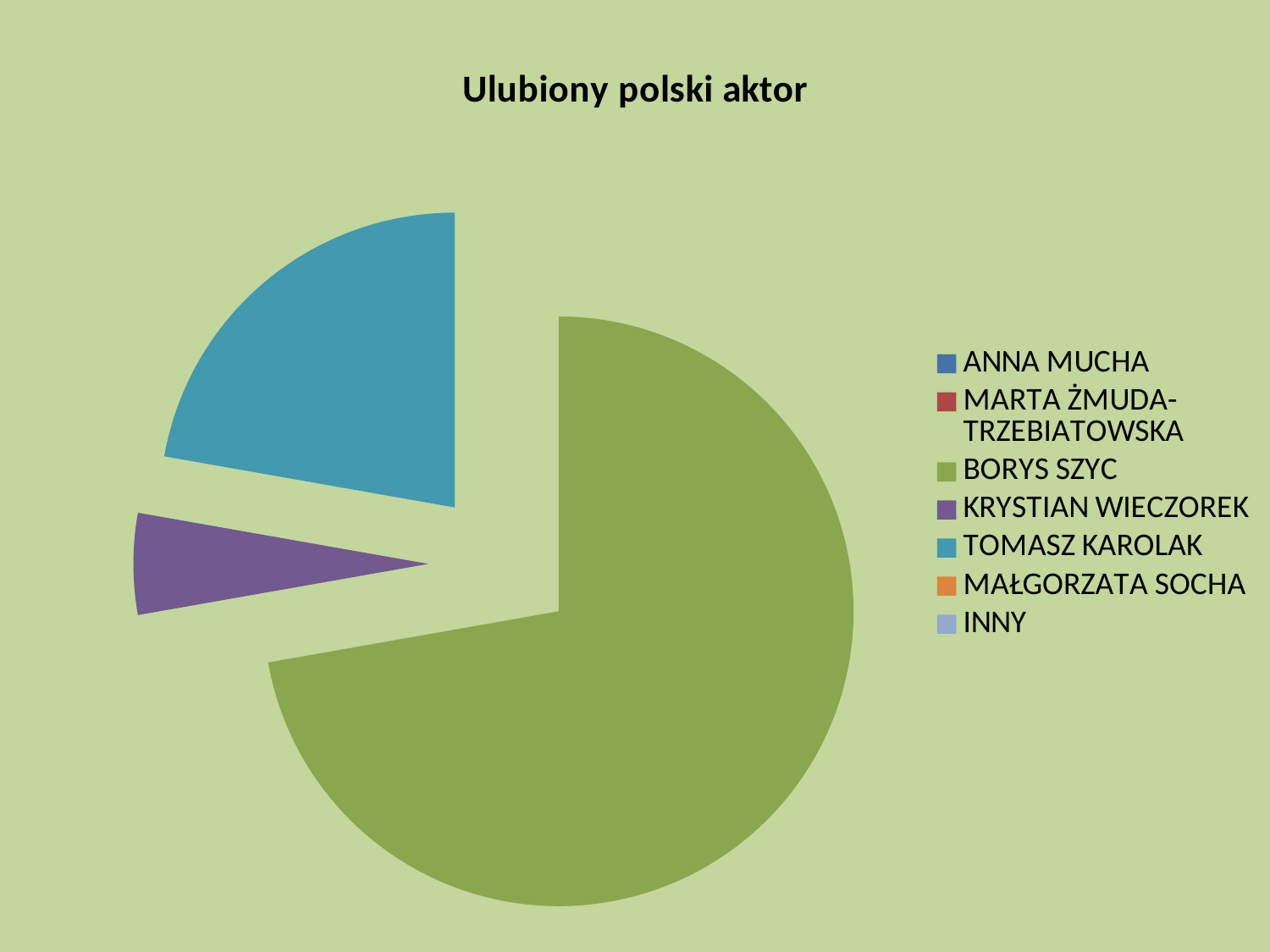
Does the BORYS SZYC slice make up more or less than half of the pie? more Which slice is larger, TOMASZ KAROLAK or KRYSTIAN WIECZOREK? TOMASZ KAROLAK Which category is shown in blue in the pie? TOMASZ KAROLAK Which category has the largest slice of the pie? BORYS SZYC What is the title of the chart? Ulubiony polski aktor How many slices are visible in the pie? 3 What kind of chart is shown on the slide? Pie chart Which slice is larger, BORYS SZYC or TOMASZ KAROLAK? BORYS SZYC Which of the visible slices is the smallest? KRYSTIAN WIECZOREK How many entries does the chart's legend list? 7